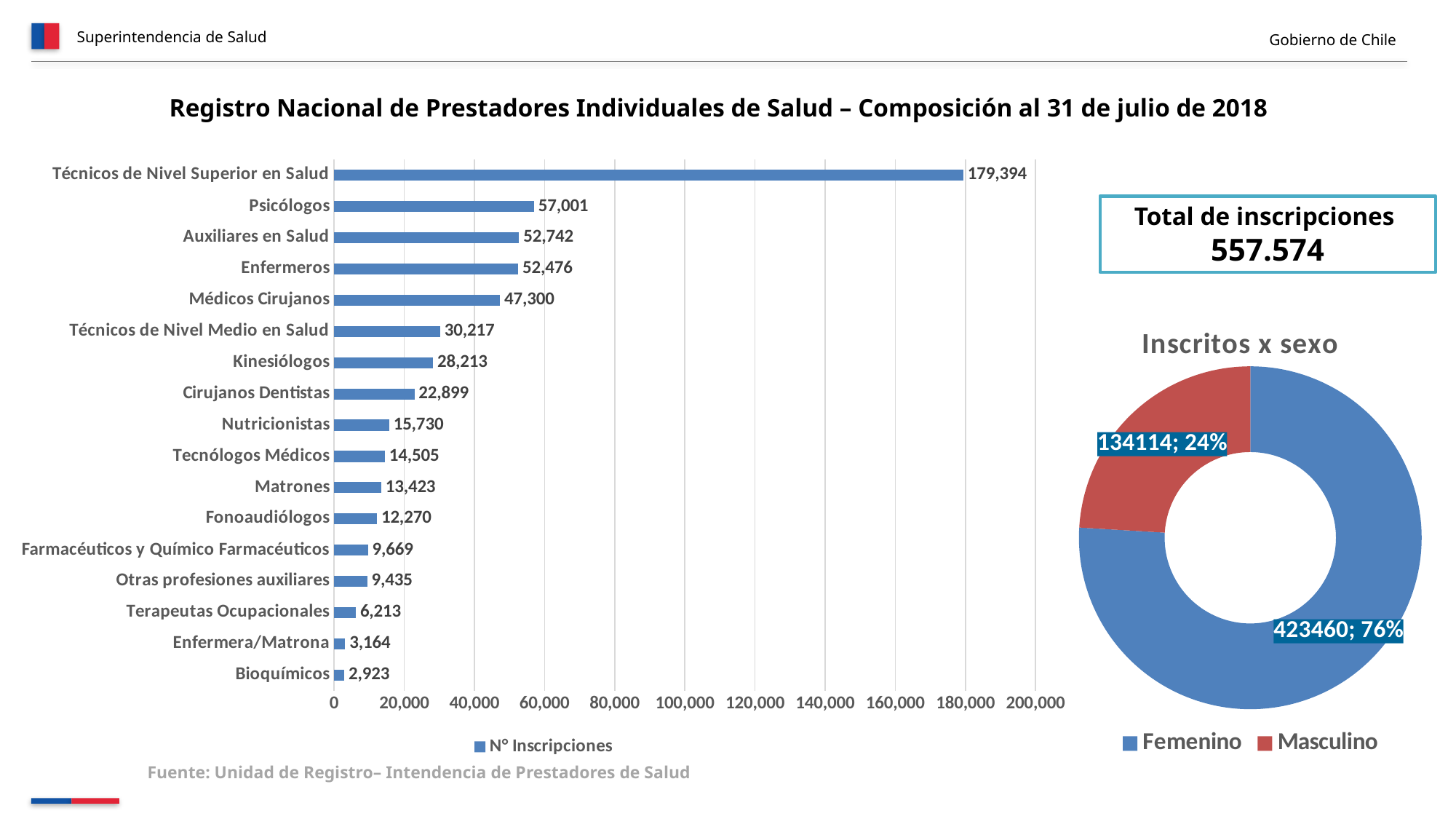
How many series does the legend of the 'Inscritos x sexo' chart list? 2 What kind of chart is the chart on the left? Bar chart In the bar chart on the left, how many categories are shown? 17 What is the legend entry of the bar chart on the left? N° Inscripciones In the 'Inscritos x sexo' chart, what is the value for Femenino? 423460 In the 'Inscritos x sexo' chart, what share of the total is Masculino? 24% In the bar chart on the left, which category has the highest value? Técnicos de Nivel Superior en Salud In the bar chart on the left, which category has the lowest value? Bioquímicos In the bar chart on the left, what is the value for Médicos Cirujanos? 47,300 In the bar chart on the left, what is the value for Psicólogos? 57,001 In the bar chart on the left, what is the difference between Psicólogos and Auxiliares en Salud? 4,259 In the bar chart on the left, which is larger: Kinesiólogos or Cirujanos Dentistas? Kinesiólogos